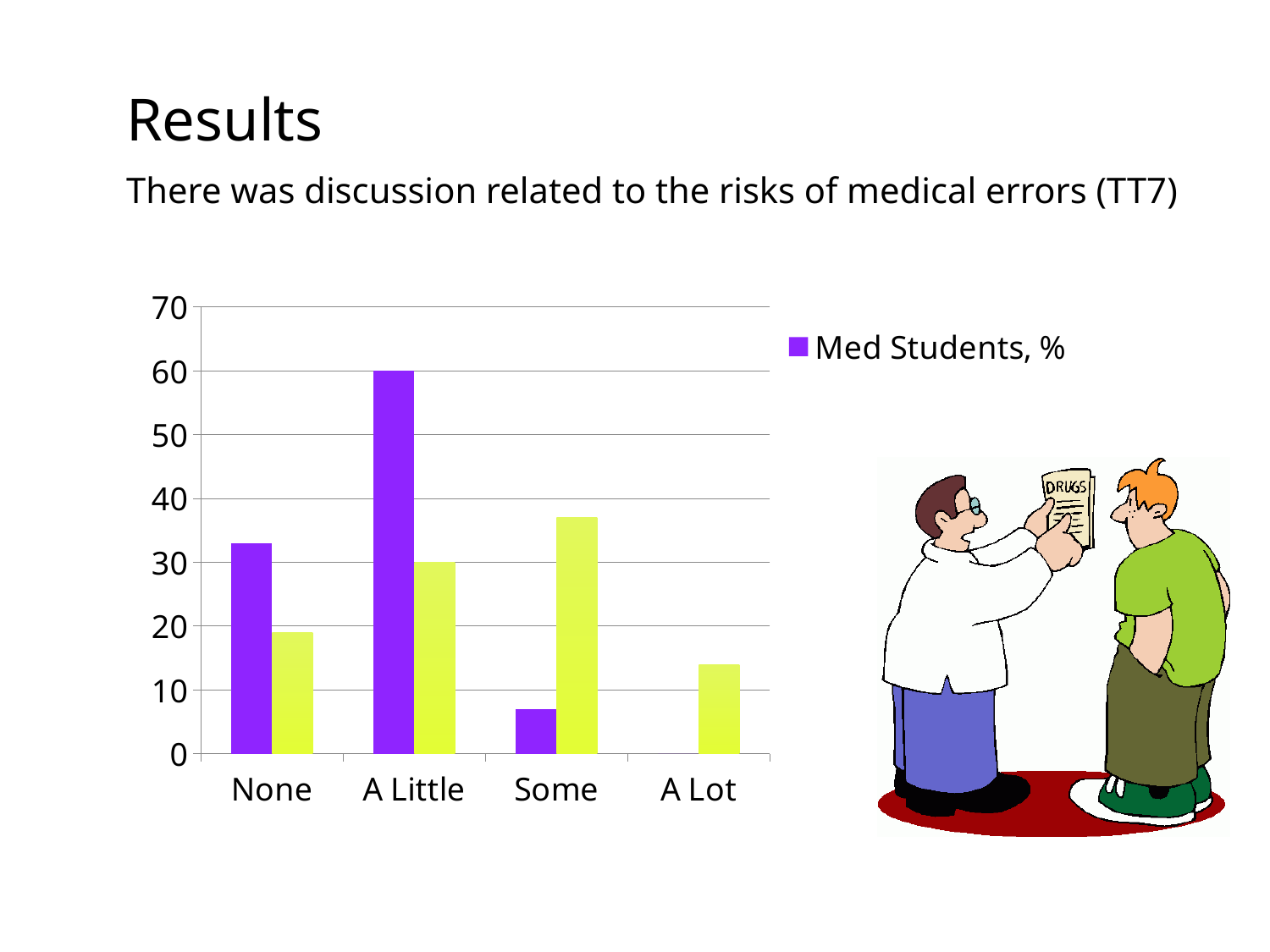
For which category is the Med Students, % value highest? A Little In the 'A Little' category, what is the difference between the Med Students, % value and the yellow-green bar value? 30 What is the Med Students, % value for the 'A Little' category? 60 How many series does the chart's legend list? 1 For which category is the yellow-green bar lowest? A Lot How many categories are shown on the x axis of the chart? 4 Is the Med Students, % value for 'Some' greater or less than 10? less For which category is the yellow-green bar highest? Some Is the Med Students, % value for 'None' greater or less than 30? greater What is the value of the yellow-green bar for the 'A Little' category? 30 What kind of chart is shown on the slide? bar chart In the 'None' category, which bar is larger: the Med Students, % bar or the yellow-green bar? Med Students, %